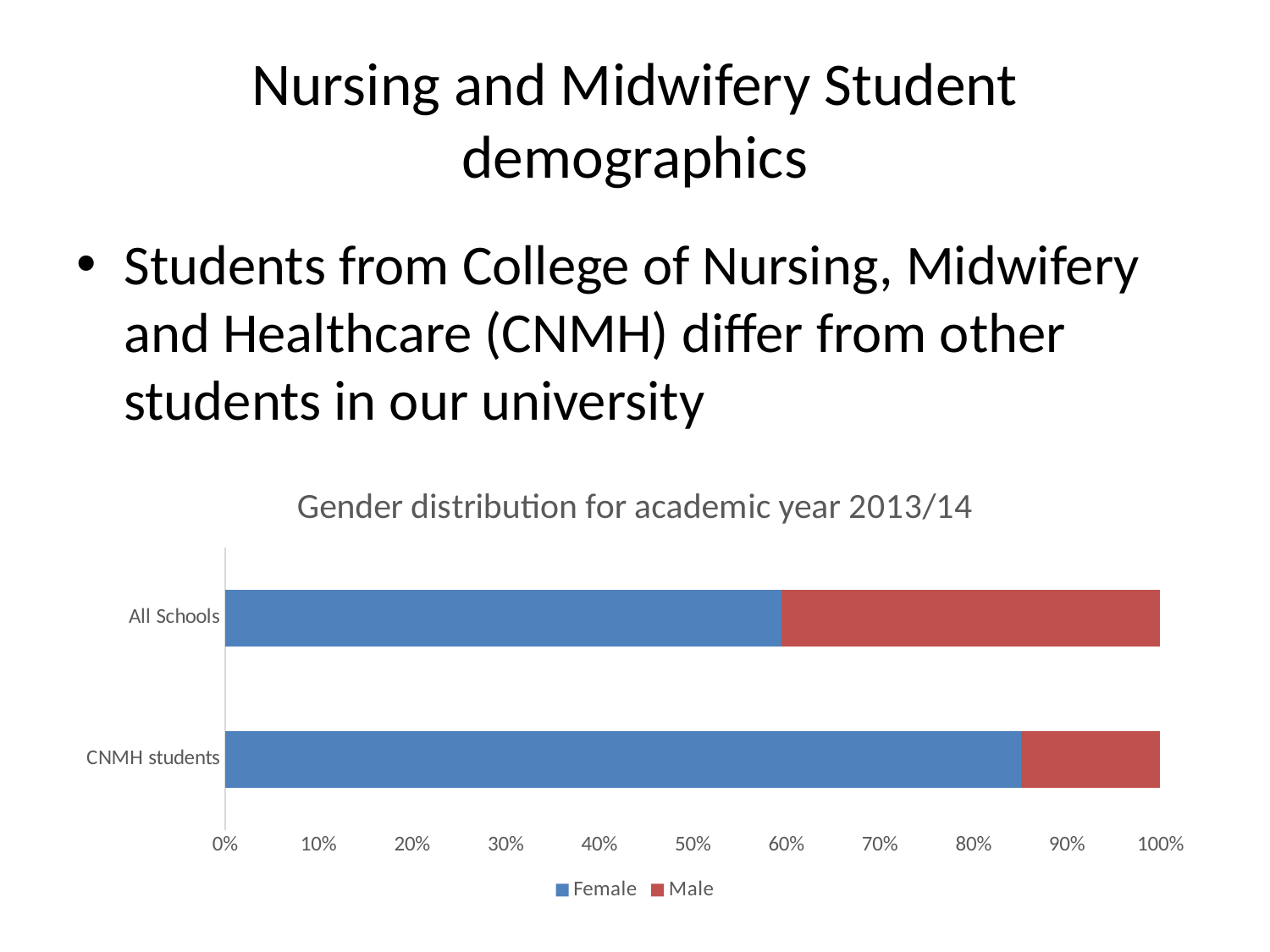
Is the Female share for CNMH students greater or less than 80%? greater Which series is shown in blue in the chart? Female Is the Female share for All Schools greater or less than 50%? greater Which category has the larger Male share, All Schools or CNMH students? All Schools Is the Male share for CNMH students greater or less than 20%? less How many series does the chart legend list? 2 What is the total of the stacked bar for All Schools? 100% What kind of chart is shown on the slide? bar chart How many categories are plotted on the chart? 2 Which category has the larger Female share, All Schools or CNMH students? CNMH students What is the title of the chart? Gender distribution for academic year 2013/14